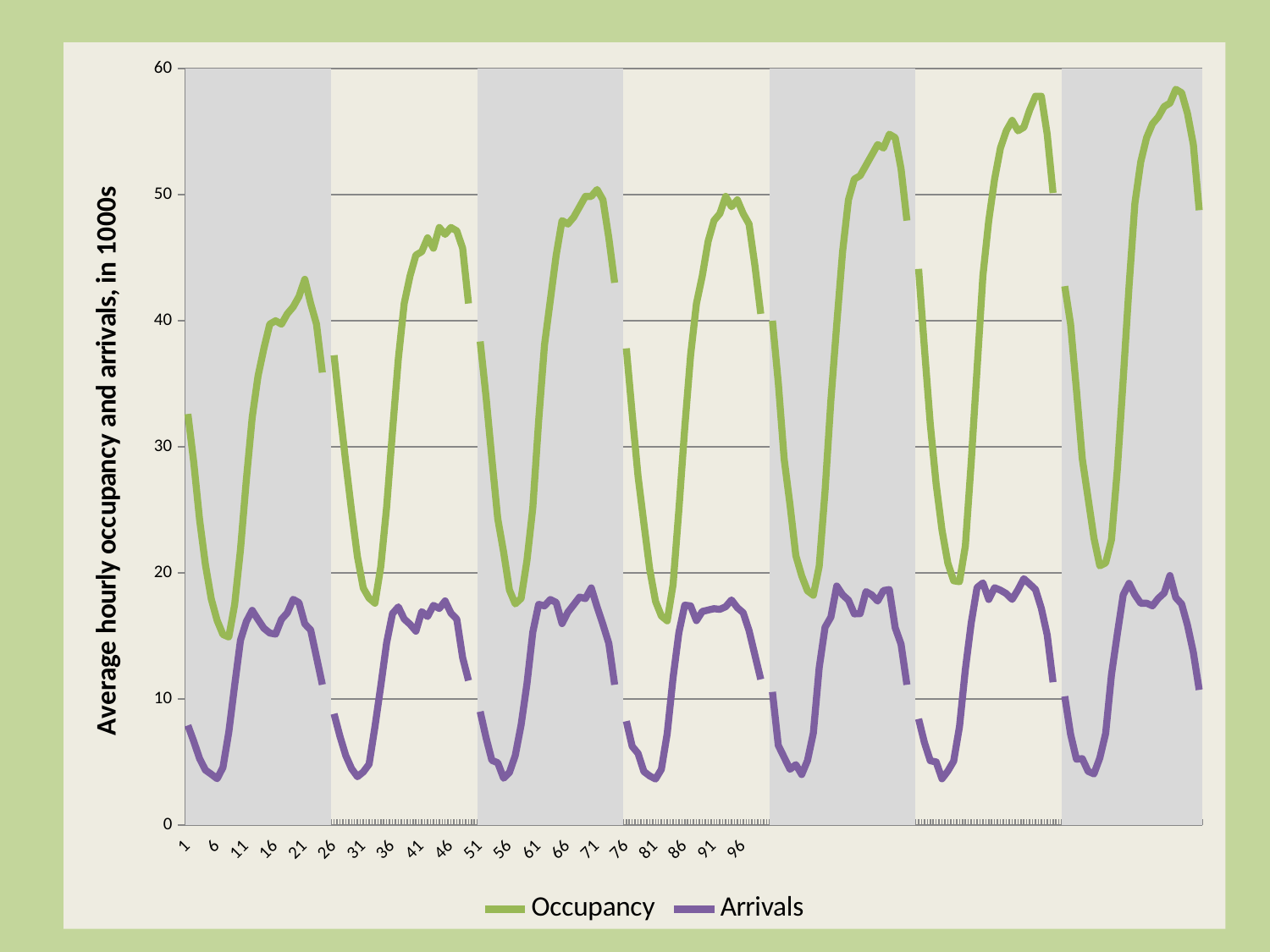
Is the Arrivals value at x = 1 greater or less than 10? less How many series does the legend list? 2 What kind of chart is shown on the slide? Line chart What is the title of the vertical axis? Average hourly occupancy and arrivals, in 1000s Do the peaks of the Occupancy series rise or fall from the first cycle to the last cycle along the x axis? rise What are the two series named in the legend? Occupancy and Arrivals Is the highest Occupancy value in the last cycle on the right greater or less than 50? greater Is the Occupancy value at x = 1 greater or less than 40? less Which series is plotted in green? Occupancy Which series has the higher value at x = 1, Occupancy or Arrivals? Occupancy